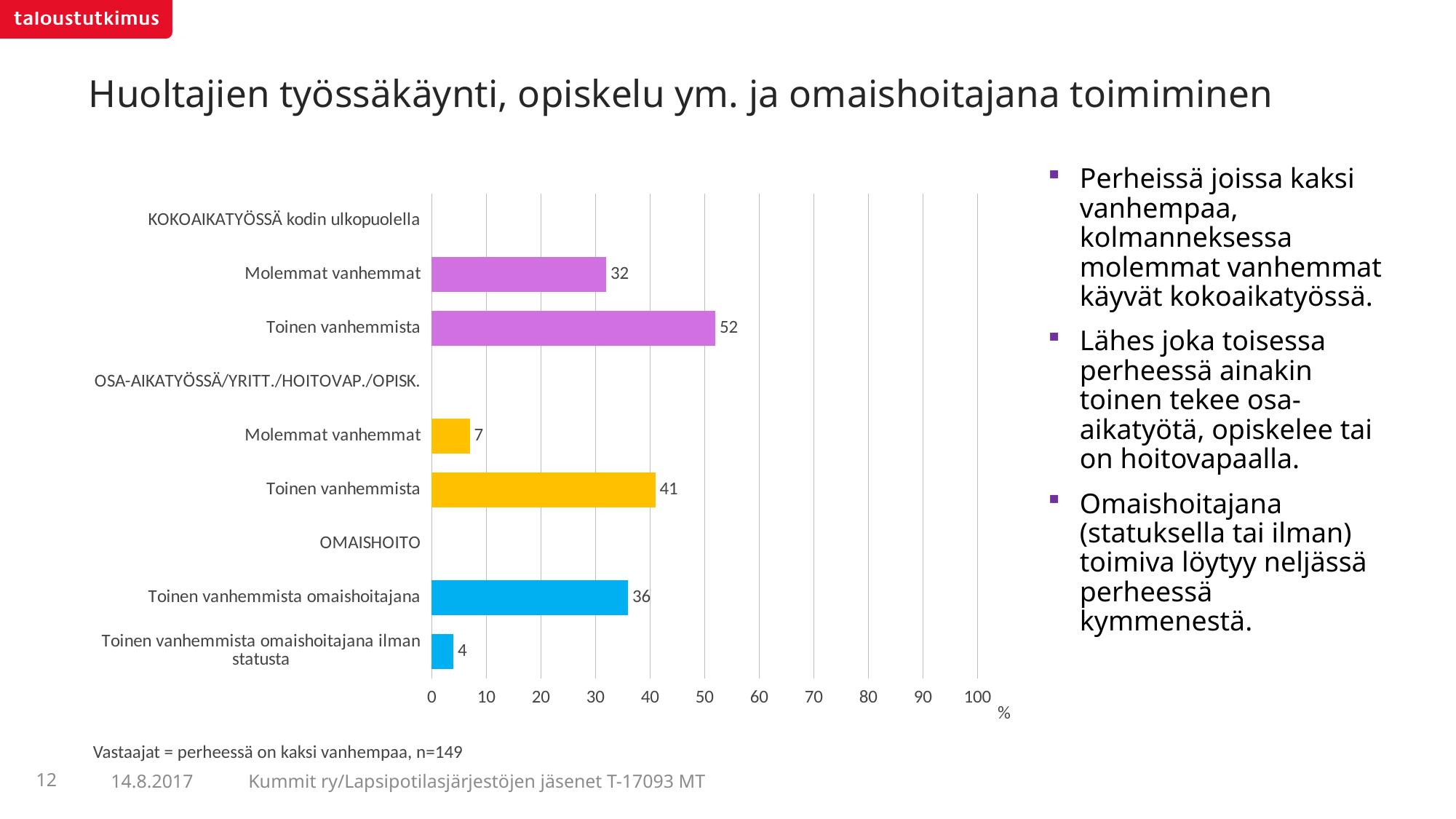
What is the value for 'Molemmat vanhemmat' under KOKOAIKATYÖSSÄ kodin ulkopuolella? 32 What is the difference between 'Toinen vanhemmista' and 'Molemmat vanhemmat' under KOKOAIKATYÖSSÄ kodin ulkopuolella? 20 What is the maximum value shown on the horizontal axis of the chart? 100 How many bars with values are plotted in the chart? 6 What is the value for 'Toinen vanhemmista omaishoitajana ilman statusta'? 4 What kind of chart is shown on the slide? Bar chart Which bar has the highest value in the chart? Toinen vanhemmista (KOKOAIKATYÖSSÄ kodin ulkopuolella) Which is larger: 'Toinen vanhemmista' under OSA-AIKATYÖSSÄ/YRITT./HOITOVAP./OPISK. or 'Toinen vanhemmista omaishoitajana'? Toinen vanhemmista (OSA-AIKATYÖSSÄ/YRITT./HOITOVAP./OPISK.) What is the value for 'Toinen vanhemmista' under KOKOAIKATYÖSSÄ kodin ulkopuolella? 52 What is the value for 'Molemmat vanhemmat' under OSA-AIKATYÖSSÄ/YRITT./HOITOVAP./OPISK.? 7 Which bar has the lowest value in the chart? Toinen vanhemmista omaishoitajana ilman statusta What is the difference between 'Toinen vanhemmista omaishoitajana' and 'Toinen vanhemmista omaishoitajana ilman statusta'? 32